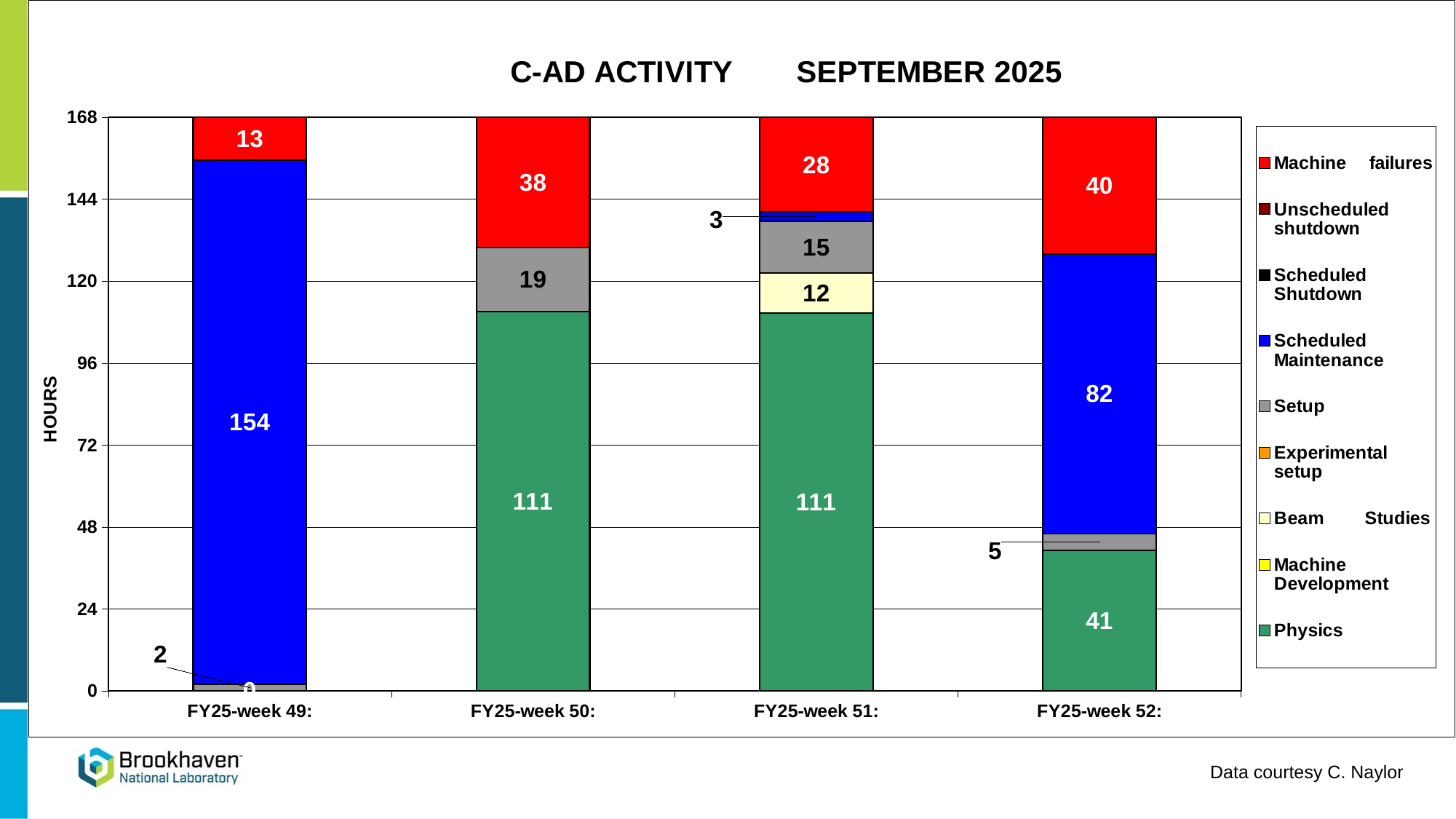
Which week has the highest number of Machine failures hours? FY25-week 52 What is the total number of hours in the stacked bar for FY25-week 50? 168 How many hours of Scheduled Maintenance are shown for FY25-week 49? 154 How many weeks are shown on the x axis? 4 How many hours of Setup are shown for FY25-week 52? 5 Which week has more Setup hours, FY25-week 50 or FY25-week 51? FY25-week 50 Which week has the lowest number of Machine failures hours? FY25-week 49 How many hours of Physics are shown for FY25-week 50? 111 How many hours of Machine failures are shown for FY25-week 52? 40 What is the difference in Scheduled Maintenance hours between FY25-week 49 and FY25-week 52? 72 How many series does the legend list? 9 How many hours of Beam Studies are shown for FY25-week 51? 12